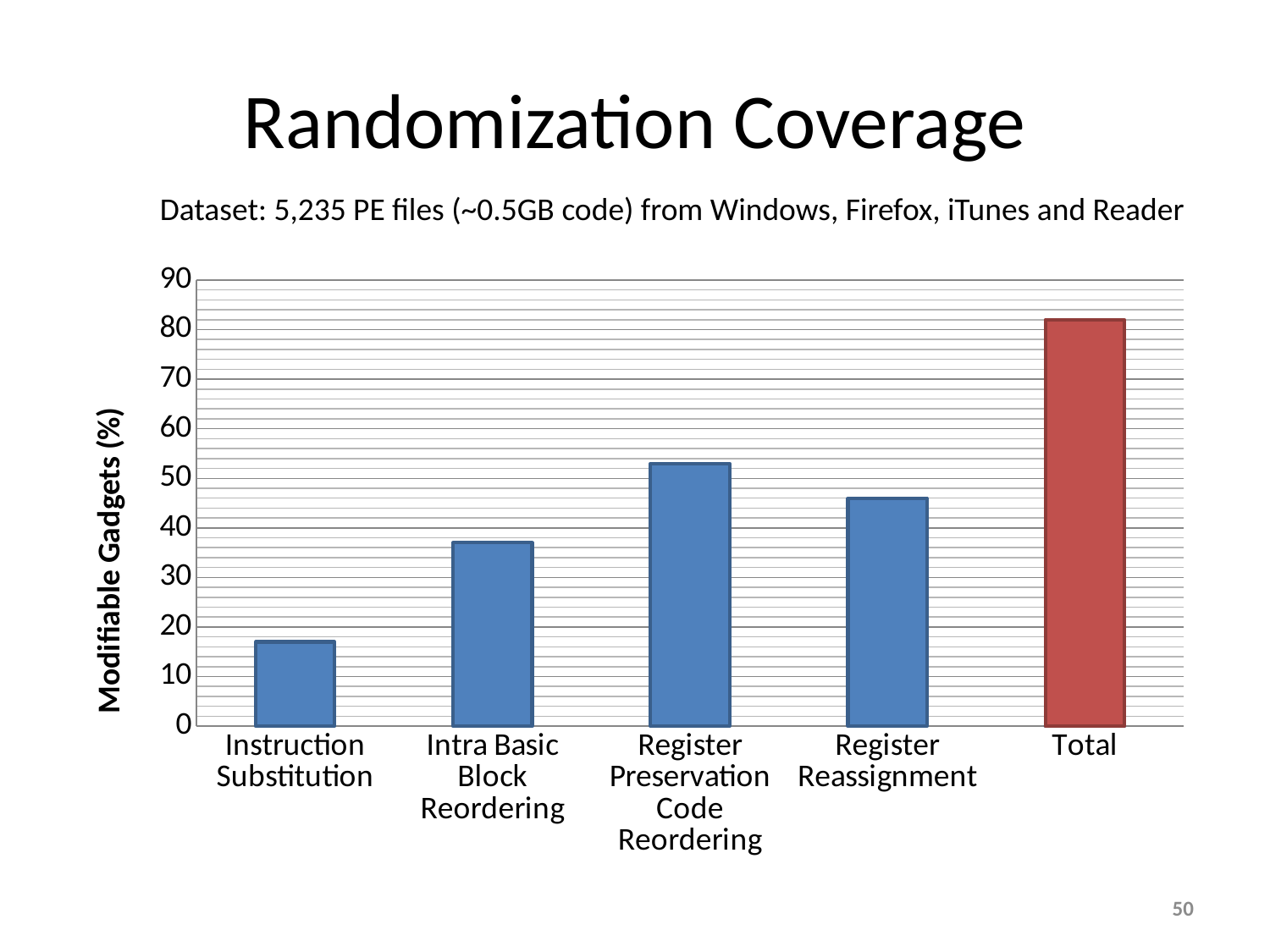
How many categories are plotted on the x axis? 5 Is the value for Register Preservation Code Reordering greater or less than 50? greater Which category's bar is coloured red rather than blue? Total Which category has the highest value? Total Is the value for Register Reassignment greater or less than 50? less What is the title of the y axis? Modifiable Gadgets (%) What kind of chart is shown on the slide? bar chart Which category has the lowest value? Instruction Substitution Which is larger, the value for Register Preservation Code Reordering or the value for Register Reassignment? Register Preservation Code Reordering Is the value for Total greater or less than 80? greater